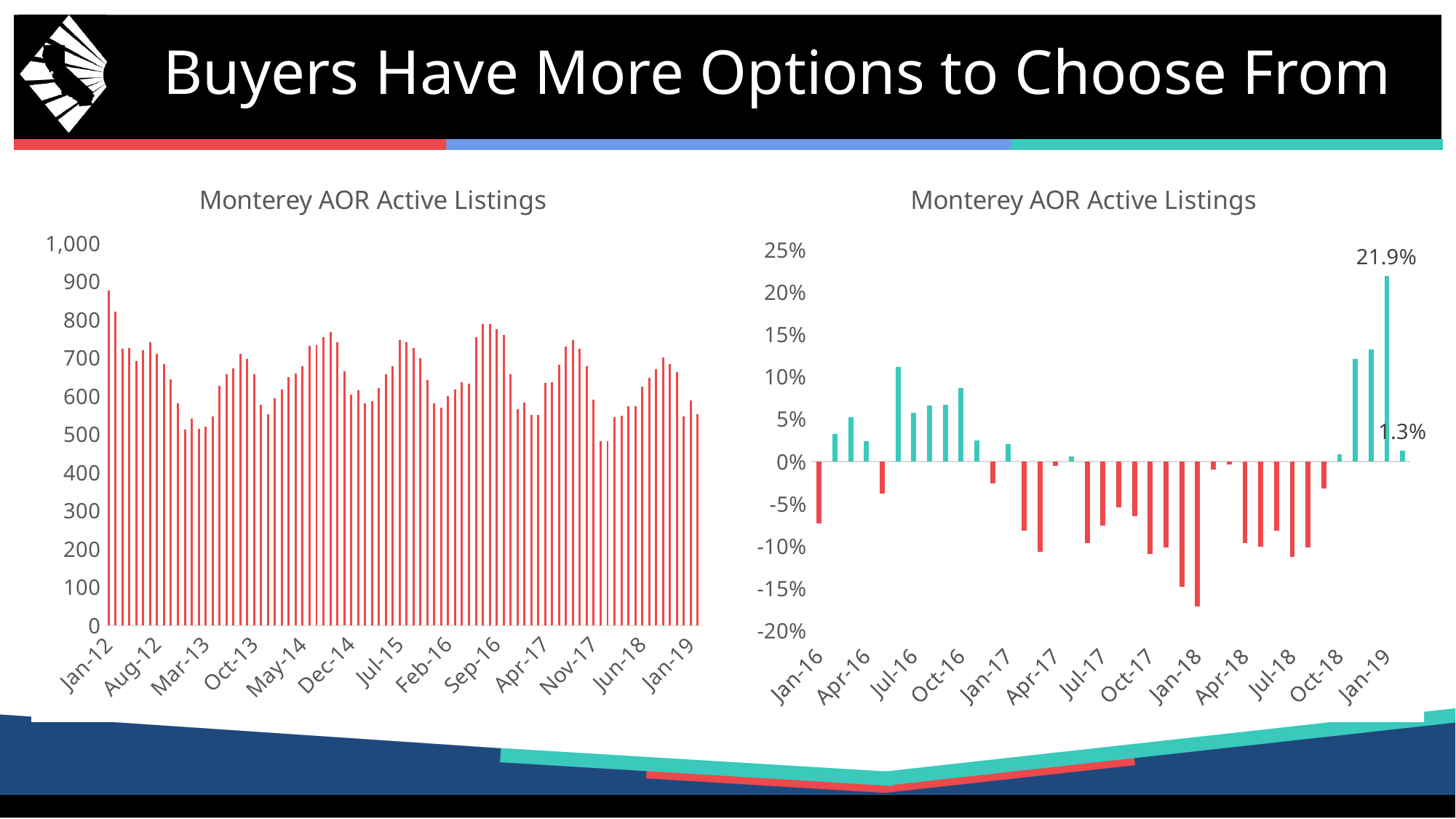
In the right chart (percent change), is the value for Jul-16 greater or less than 10%? less In the right chart (percent change), what colour are the bars with negative values? red In the left chart (listing counts), which is larger, the value for Jan-12 or the value for Jan-19? Jan-12 In the right chart (percent change), what is the value labeled on the last bar? 1.3% In the left chart (listing counts), which month has the highest number of active listings? Jan-12 In the right chart (percent change), is the value for Jan-18 greater or less than -15%? less What kind of chart is the left chart, Monterey AOR Active Listings? bar chart In the right chart (percent change), what is the highest value shown with a data label? 21.9% In the right chart (percent change), is the value for Jan-16 greater or less than -5%? less In the right chart (percent change), what is the difference between the two labeled values, 21.9% and 1.3%? 20.6%